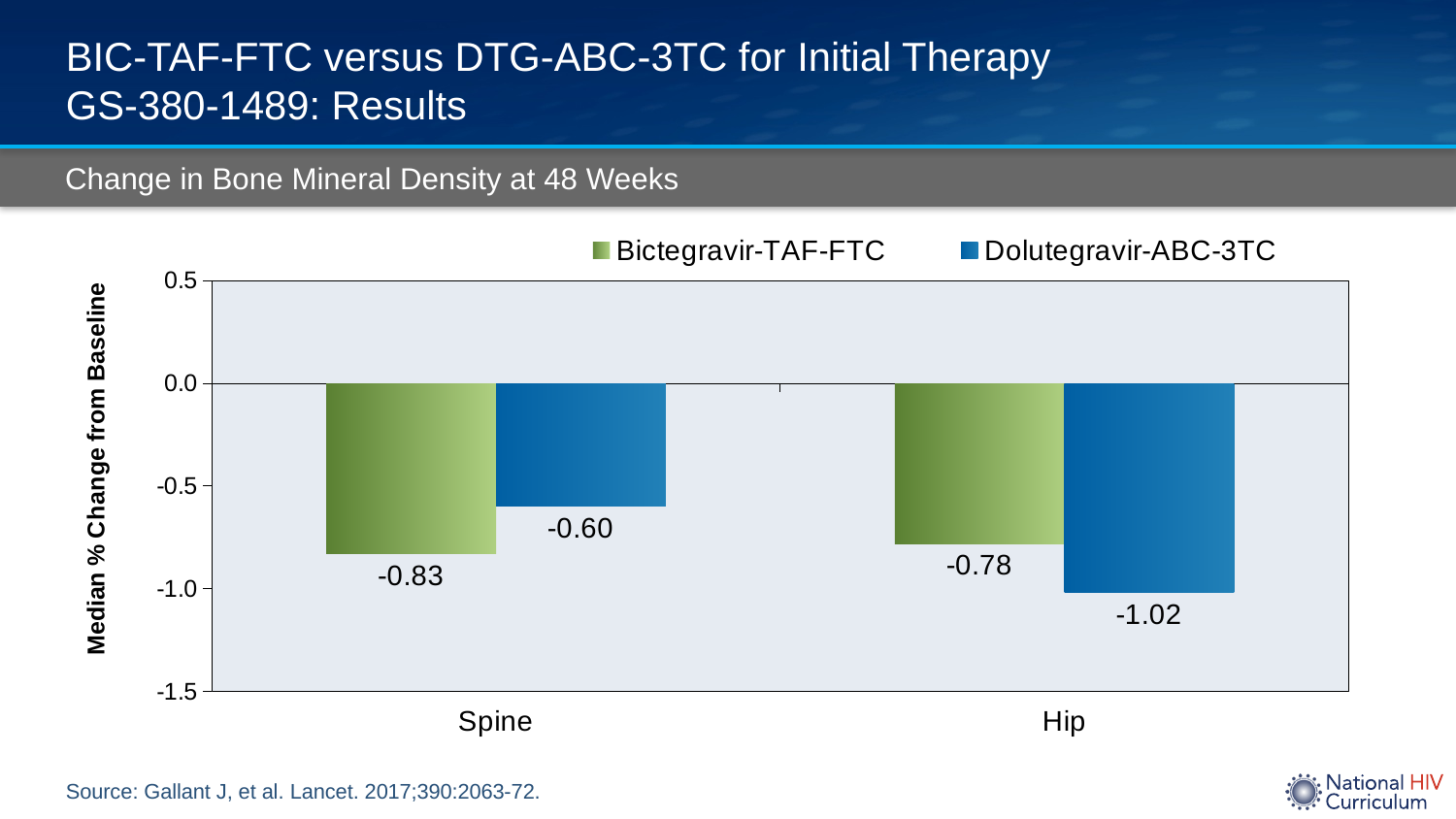
What is the difference between the spine values for Bictegravir-TAF-FTC and Dolutegravir-ABC-3TC? 0.23 What is the median % change from baseline in bone mineral density at the spine for Bictegravir-TAF-FTC? -0.83 What is the median % change from baseline in bone mineral density at the hip for Dolutegravir-ABC-3TC? -1.02 Which bar shows the largest decrease in bone mineral density? Dolutegravir-ABC-3TC at the hip What kind of chart is shown on the slide? Bar chart At the hip, which regimen shows a greater decrease in bone mineral density? Dolutegravir-ABC-3TC What is the median % change from baseline at the spine for Dolutegravir-ABC-3TC? -0.60 Which bar shows the smallest decrease in bone mineral density? Dolutegravir-ABC-3TC at the spine What is the median % change from baseline at the hip for Bictegravir-TAF-FTC? -0.78 How many series does the legend list? 2 How many categories are shown on the x axis? 2 What is the difference between the hip values for Dolutegravir-ABC-3TC and Bictegravir-TAF-FTC? 0.24